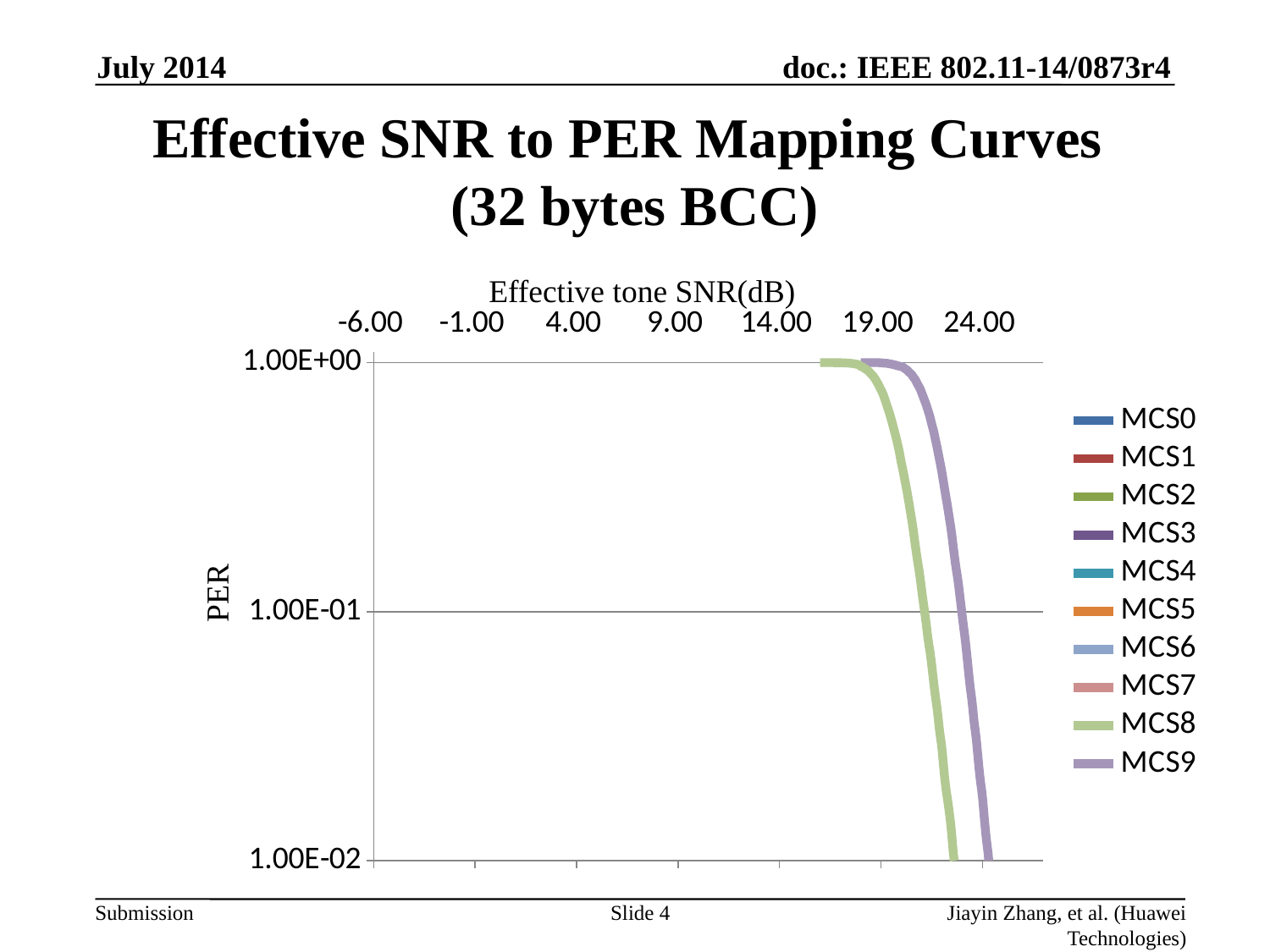
Which of the two visible curves, MCS8 or MCS9, reaches a PER of 1.00E-02 at a lower SNR? MCS8 What is the lowest PER value shown on the vertical axis? 1.00E-02 Is the SNR at which the MCS9 curve crosses a PER of 1.00E-01 greater or less than 19.00 dB? greater Which of the two visible curves, MCS8 or MCS9, reaches a PER of 1.00E-01 at a higher SNR? MCS9 What kind of chart is shown on the slide? line chart What is the label of the horizontal axis? Effective tone SNR(dB) Do the plotted PER curves rise or fall as the effective tone SNR increases? fall Is the SNR at which the MCS8 curve crosses a PER of 1.00E-01 greater or less than 14.00 dB? greater How many series does the legend list? 10 Is the SNR at which the MCS8 curve crosses a PER of 1.00E-02 greater or less than 24.00 dB? less What is the label of the vertical axis? PER At an effective tone SNR of 22.00 dB, which curve has the lower PER, MCS8 or MCS9? MCS8